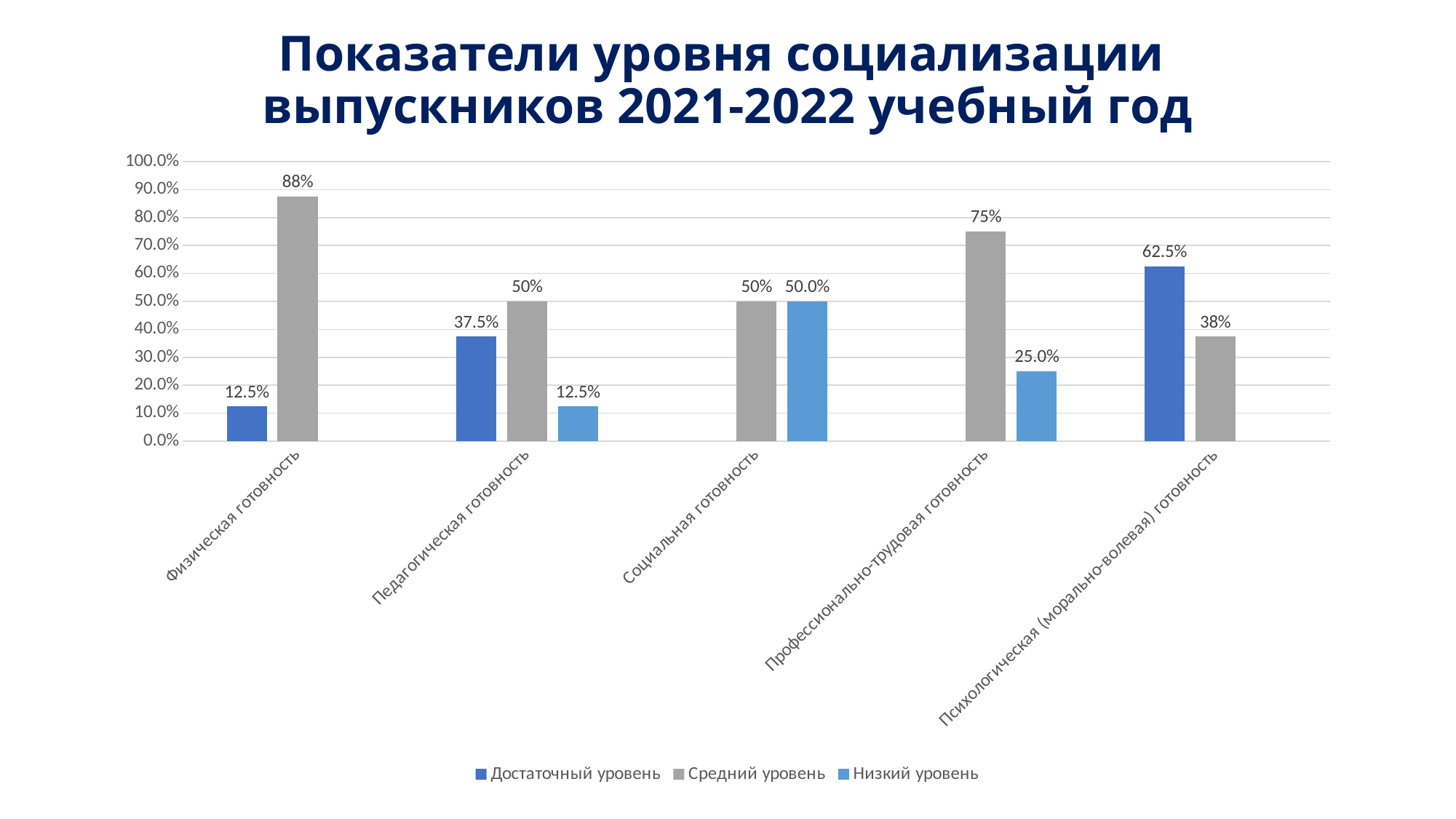
What is the value of the Низкий уровень series for Профессионально-трудовая готовность? 25.0% What is the value of the Средний уровень series for Физическая готовность? 88% Which category has the lowest value in the Достаточный уровень series? Физическая готовность How many series does the legend list? 3 What is the title of the chart? Показатели уровня социализации выпускников 2021-2022 учебный год What is the difference between the Средний уровень and Низкий уровень values for Профессионально-трудовая готовность? 50% How many categories are shown on the x axis? 5 Which category has the highest value in the Средний уровень series? Физическая готовность What is the value of the Достаточный уровень series for Педагогическая готовность? 37.5% What is the value of the Достаточный уровень series for Психологическая (морально-волевая) готовность? 62.5% For Психологическая (морально-волевая) готовность, which is larger: Достаточный уровень or Средний уровень? Достаточный уровень What kind of chart is shown on the slide? Bar chart